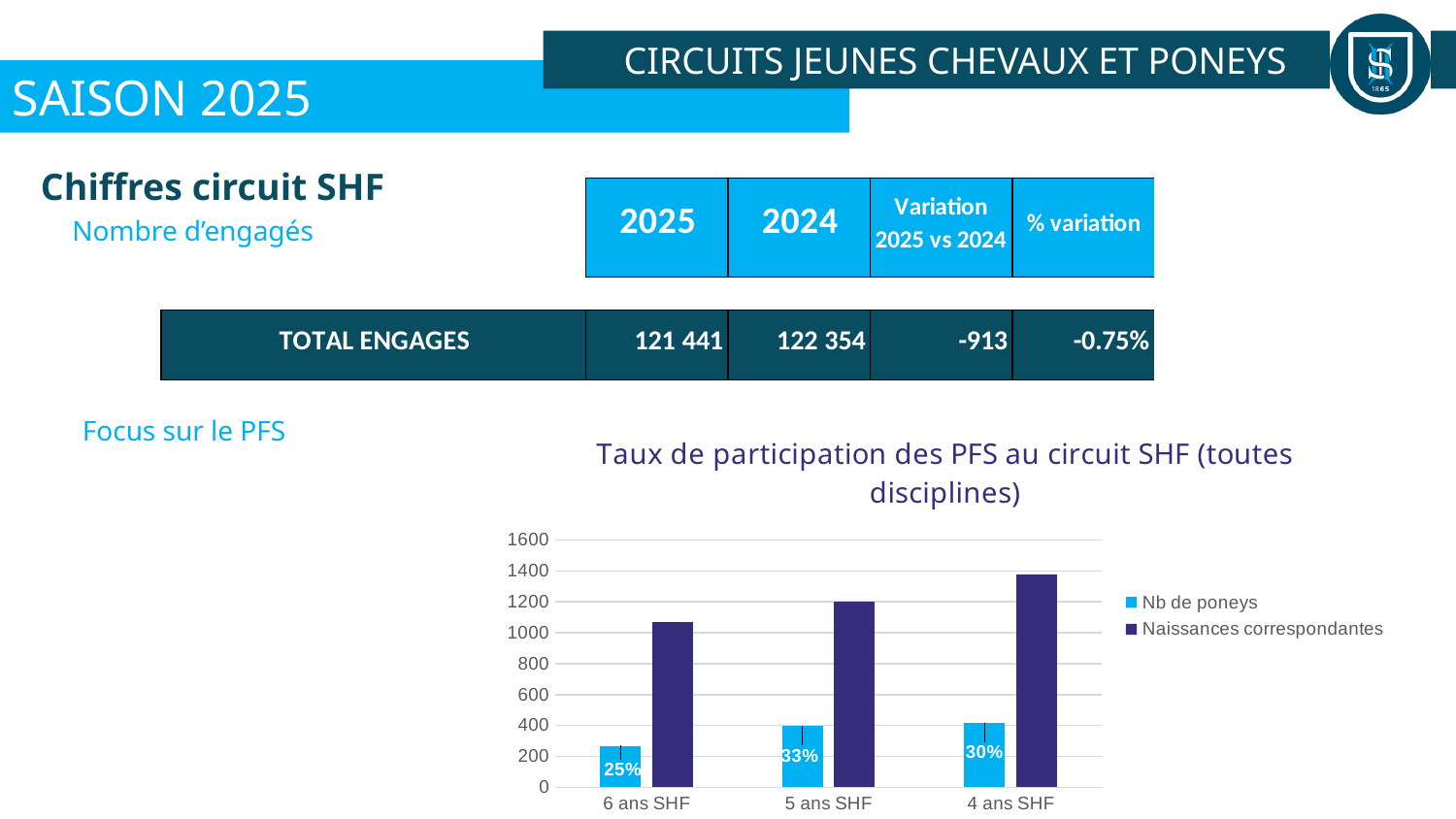
Is the 'Nb de poneys' value for 6 ans SHF greater or less than 400? less What percentage label is printed on the 'Nb de poneys' bar for 5 ans SHF? 33% Which category has the highest value for 'Naissances correspondantes'? 4 ans SHF Do the 'Naissances correspondantes' values rise or fall from left to right along the x axis? rise How many categories are shown on the x axis of the chart? 3 What kind of chart is shown under 'Taux de participation des PFS au circuit SHF (toutes disciplines)'? bar chart How many series does the chart's legend list? 2 What percentage label is printed on the 'Nb de poneys' bar for 4 ans SHF? 30% Which is larger: 'Naissances correspondantes' for 5 ans SHF or for 6 ans SHF? 5 ans SHF Is the 'Naissances correspondantes' value for 4 ans SHF greater or less than 1200? greater What percentage label is printed on the 'Nb de poneys' bar for 6 ans SHF? 25% Which category has the lowest value for 'Nb de poneys'? 6 ans SHF